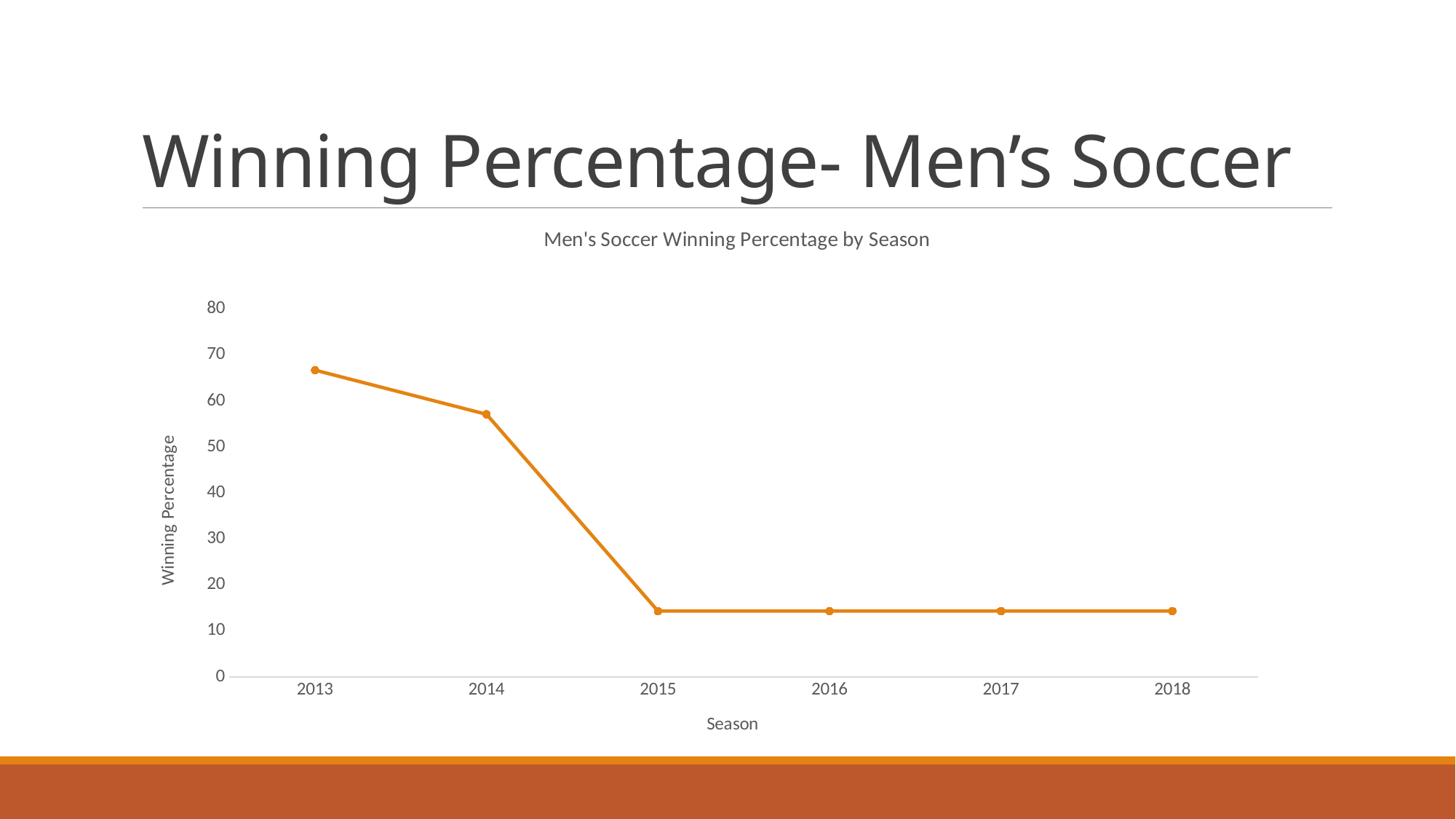
What is the title of the chart? Men's Soccer Winning Percentage by Season Does the winning percentage generally rise or fall from 2013 to 2018? fall Is the winning percentage for 2018 greater or less than 10? greater Is the winning percentage for 2014 greater or less than 50? greater Which season has the highest winning percentage? 2013 Which season has the larger winning percentage, 2014 or 2016? 2014 Is the winning percentage for 2013 greater or less than 60? greater What is the label on the vertical axis of the chart? Winning Percentage Which season has the larger winning percentage, 2013 or 2014? 2013 How many seasons are plotted on the chart? 6 What kind of chart is shown on the slide? line chart